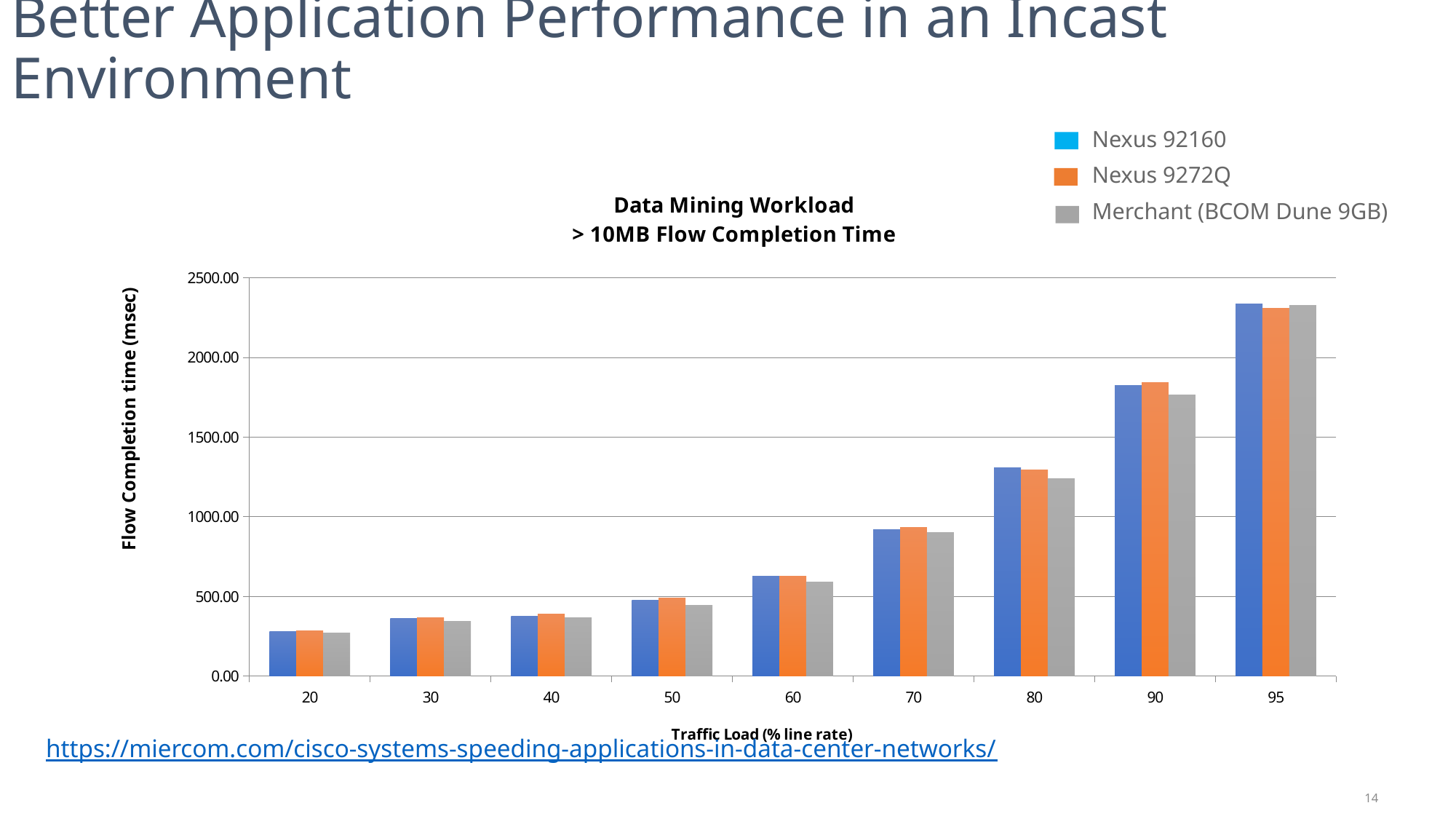
Do the flow completion times rise or fall as traffic load increases along the x axis? rise Is the value for Nexus 9272Q at traffic load 80 greater or less than 1500? less What is the title of the chart? Data Mining Workload > 10MB Flow Completion Time What is the label of the y axis? Flow Completion time (msec) At which traffic load is the Merchant (BCOM Dune 9GB) flow completion time lowest? 20 At which traffic load is the Nexus 92160 flow completion time highest? 95 At traffic load 90, which is larger: the Nexus 9272Q value or the Merchant (BCOM Dune 9GB) value? Nexus 9272Q Is the value for Nexus 92160 at traffic load 95 greater or less than 2000? greater How many traffic load categories are shown on the x axis? 9 Is the value for Merchant (BCOM Dune 9GB) at traffic load 20 greater or less than 500? less How many series does the legend list? 3 What kind of chart is shown on the slide? bar chart